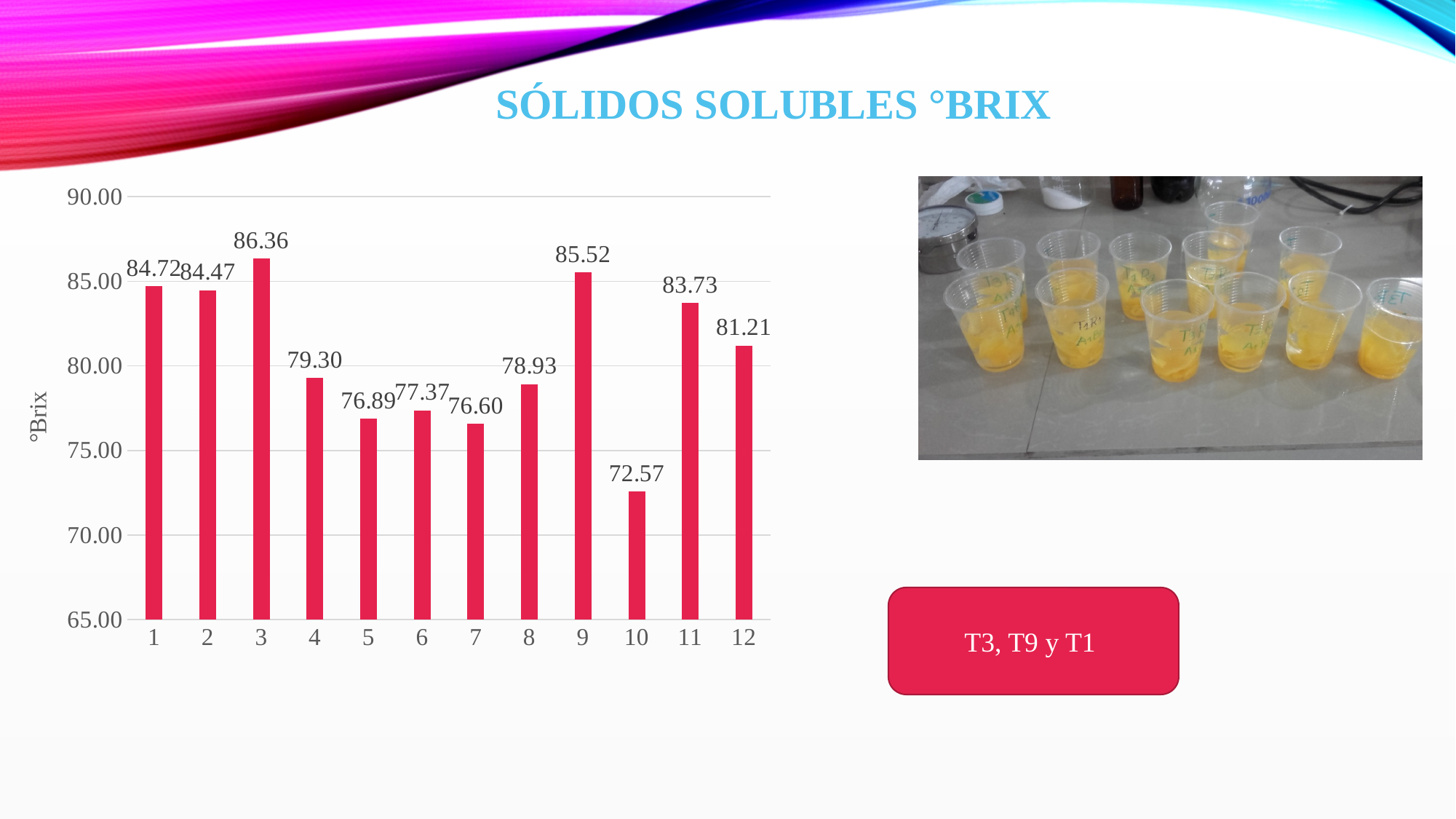
What is the value for category 12? 81.21 What kind of chart is shown? bar chart Which category has the lowest value? 10 Is the value for category 4 greater or less than 80.00? less Which category has the highest value? 3 What is the title of the chart? SÓLIDOS SOLUBLES °BRIX What is the label of the y axis? °Brix How many categories are shown on the x axis? 12 What is the value for category 10? 72.57 Which is larger, the value for category 9 or the value for category 11? 9 What is the difference between the values for category 3 and category 10? 13.79 What is the value for category 3? 86.36